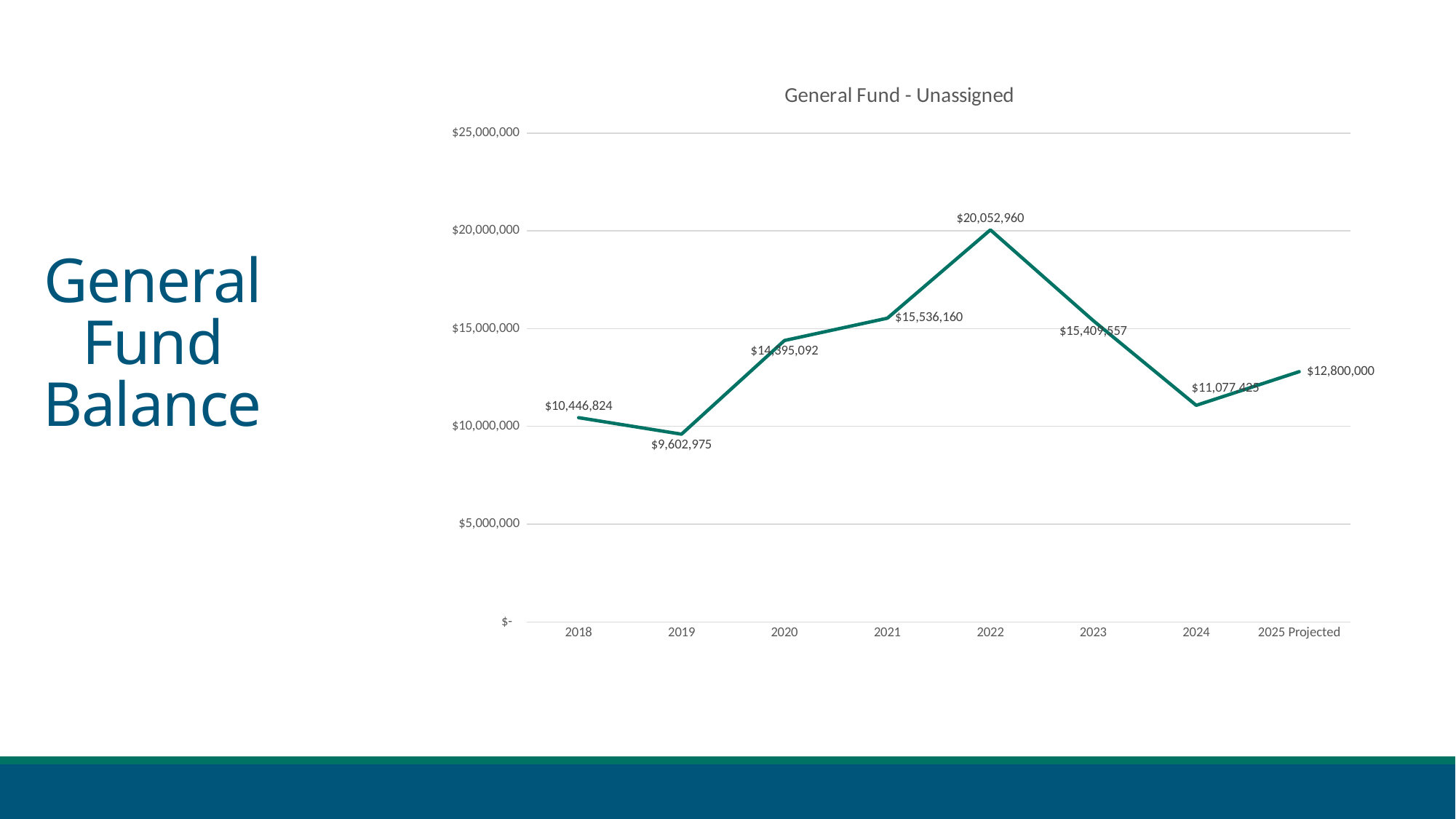
What is the title of the chart? General Fund - Unassigned Which year has the highest General Fund - Unassigned value? 2022 How many data points are plotted on the line? 8 Which year has the lowest General Fund - Unassigned value? 2019 What is the projected General Fund - Unassigned value for 2025? $12,800,000 What is the difference between the 2022 value and the 2021 value? $4,516,800 What type of chart is shown on the slide? line chart Does the General Fund - Unassigned value rise or fall from 2022 to 2024? fall What is the General Fund - Unassigned value for 2018? $10,446,824 What is the General Fund - Unassigned value for 2022? $20,052,960 Is the value for 2024 greater or less than $15,000,000? less What is the General Fund - Unassigned value for 2021? $15,536,160